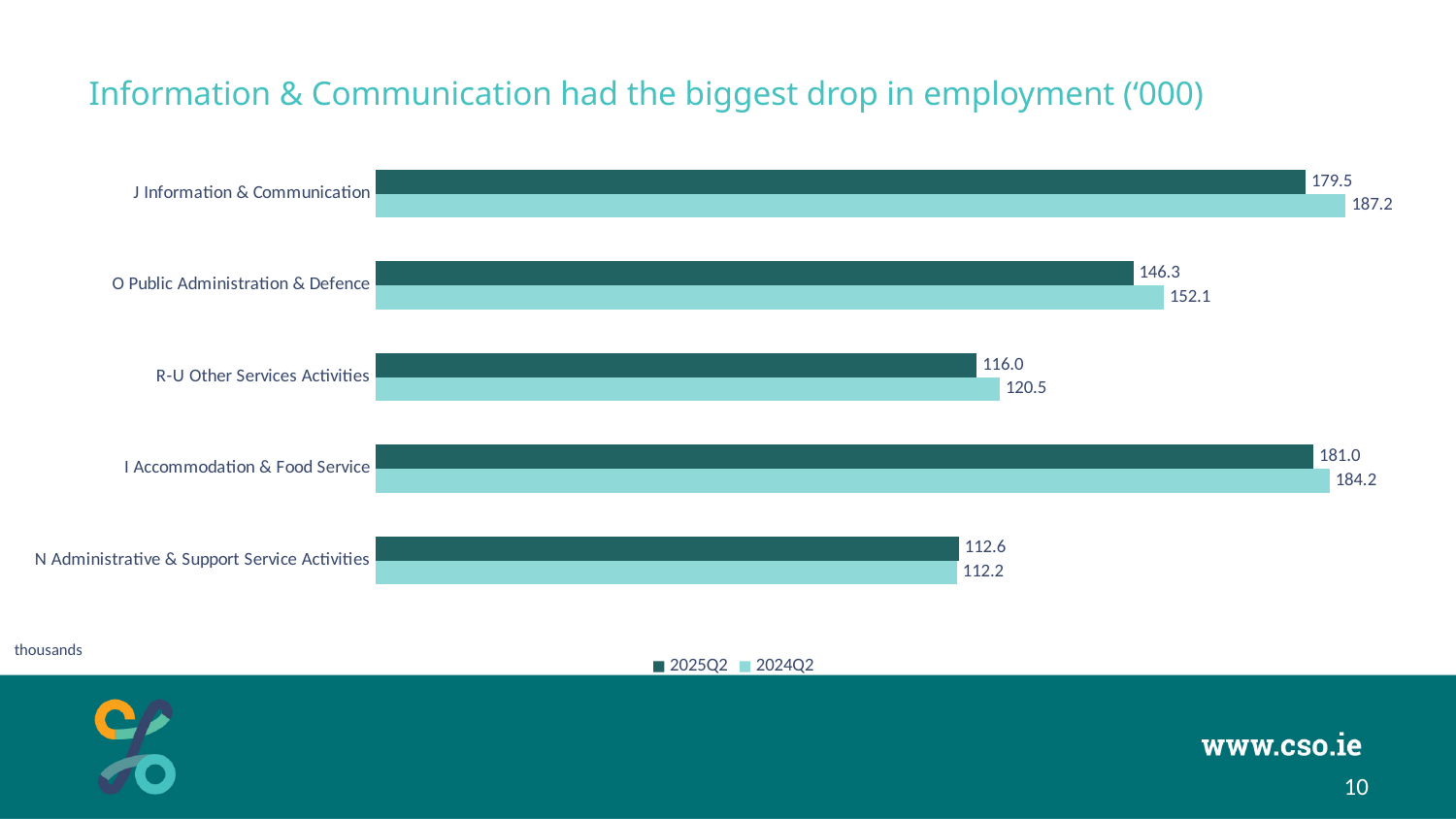
What is the 2025Q2 value for N Administrative & Support Service Activities? 112.6 How many categories are shown in the chart? 5 How many series does the legend list? 2 Which category has the highest 2024Q2 value? J Information & Communication What is the title of the chart? Information & Communication had the biggest drop in employment ('000) What is the difference between the 2024Q2 and 2025Q2 values for J Information & Communication? 7.7 What type of chart is shown on the slide? Bar chart What is the 2025Q2 value for J Information & Communication? 179.5 What is the difference between the 2024Q2 and 2025Q2 values for R-U Other Services Activities? 4.5 What is the 2024Q2 value for O Public Administration & Defence? 152.1 Which category has the lowest 2025Q2 value? N Administrative & Support Service Activities For I Accommodation & Food Service, which is larger: the 2025Q2 value or the 2024Q2 value? 2024Q2